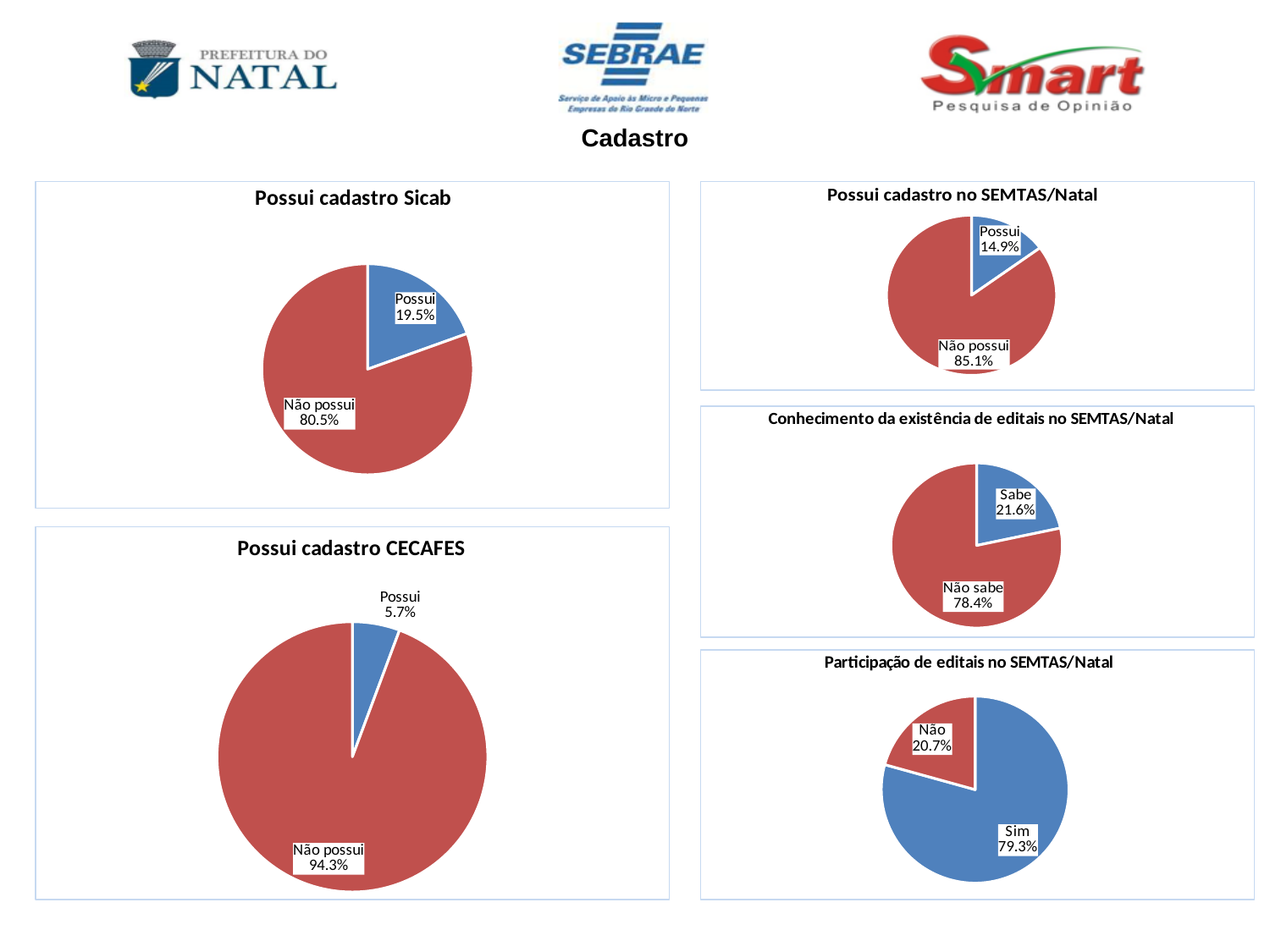
In the 'Possui cadastro no SEMTAS/Natal' chart, what percentage is shown for 'Não possui'? 85.1% In the 'Possui cadastro CECAFES' chart, which slice is the largest? Não possui In the 'Conhecimento da existência de editais no SEMTAS/Natal' chart, what percentage is shown for 'Sabe'? 21.6% In the 'Conhecimento da existência de editais no SEMTAS/Natal' chart, what is the difference between 'Não sabe' and 'Sabe'? 56.8% In the 'Possui cadastro Sicab' chart, what percentage is shown for 'Não possui'? 80.5% In the 'Possui cadastro Sicab' chart, what percentage is shown for 'Possui'? 19.5% What kind of chart is 'Possui cadastro Sicab'? Pie chart How many slices does the 'Possui cadastro CECAFES' chart have? 2 In the 'Possui cadastro CECAFES' chart, what percentage is shown for 'Possui'? 5.7% In the 'Participação de editais no SEMTAS/Natal' chart, which is larger, 'Sim' or 'Não'? Sim In the 'Possui cadastro no SEMTAS/Natal' chart, which slice is the smallest? Possui In the 'Participação de editais no SEMTAS/Natal' chart, what percentage is shown for 'Sim'? 79.3%